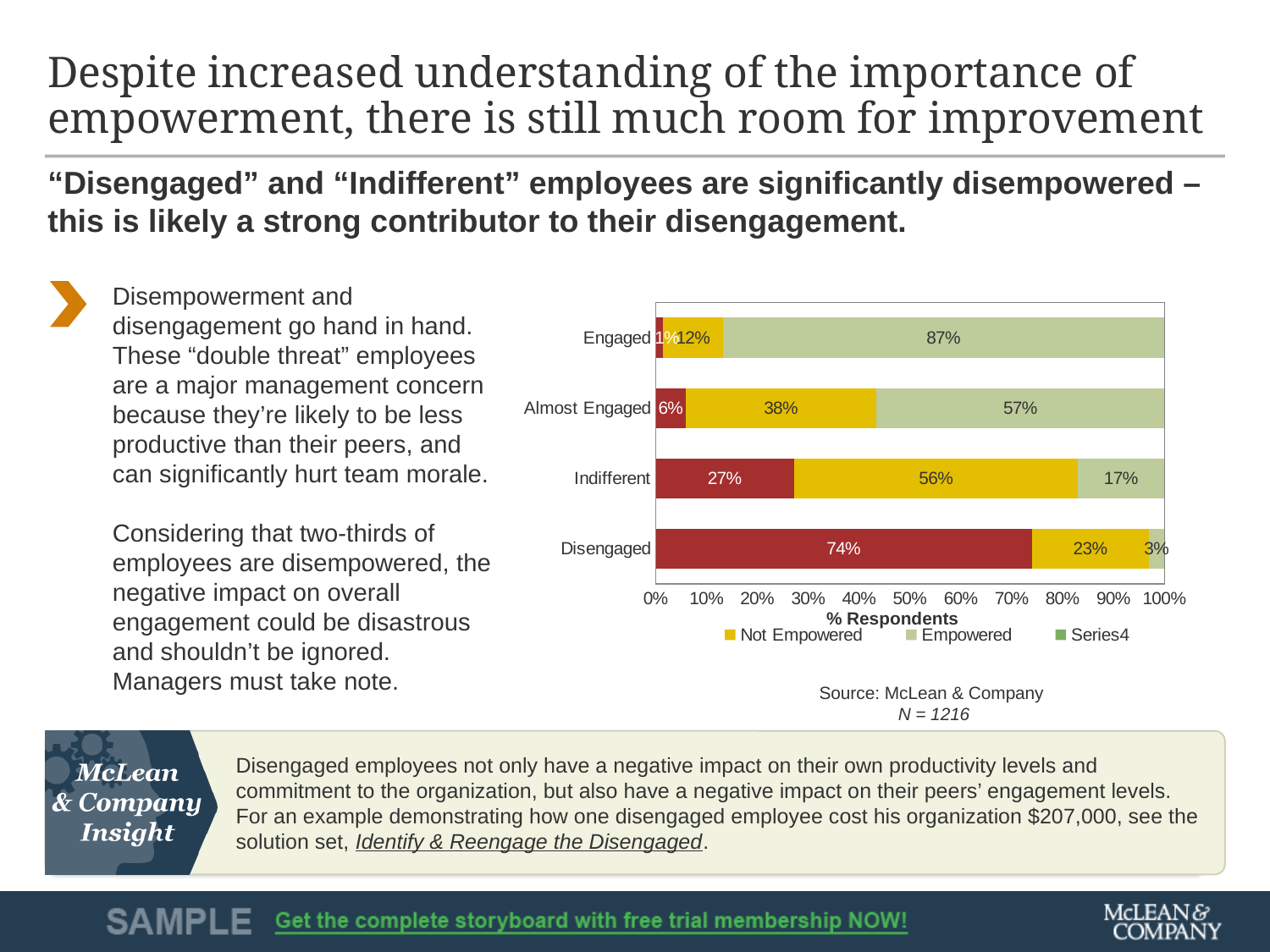
Which engagement category has the highest Empowered percentage? Engaged Which engagement category has the lowest Empowered percentage? Disengaged How many percentage points higher is the Empowered share for Engaged employees than for Almost Engaged employees? 30 percentage points Which has a larger Not Empowered percentage, Disengaged or Engaged employees? Disengaged What type of chart is shown on the slide? Stacked horizontal bar chart How many series does the chart legend list? 3 What percentage of Almost Engaged employees are Not Empowered? 38% What percentage of Engaged employees are Empowered? 87% How many engagement categories are shown on the chart? 4 What percentage of Indifferent employees are Not Empowered? 56% What percentage of Disengaged employees are Empowered? 3% Which engagement category has the highest Not Empowered percentage? Indifferent